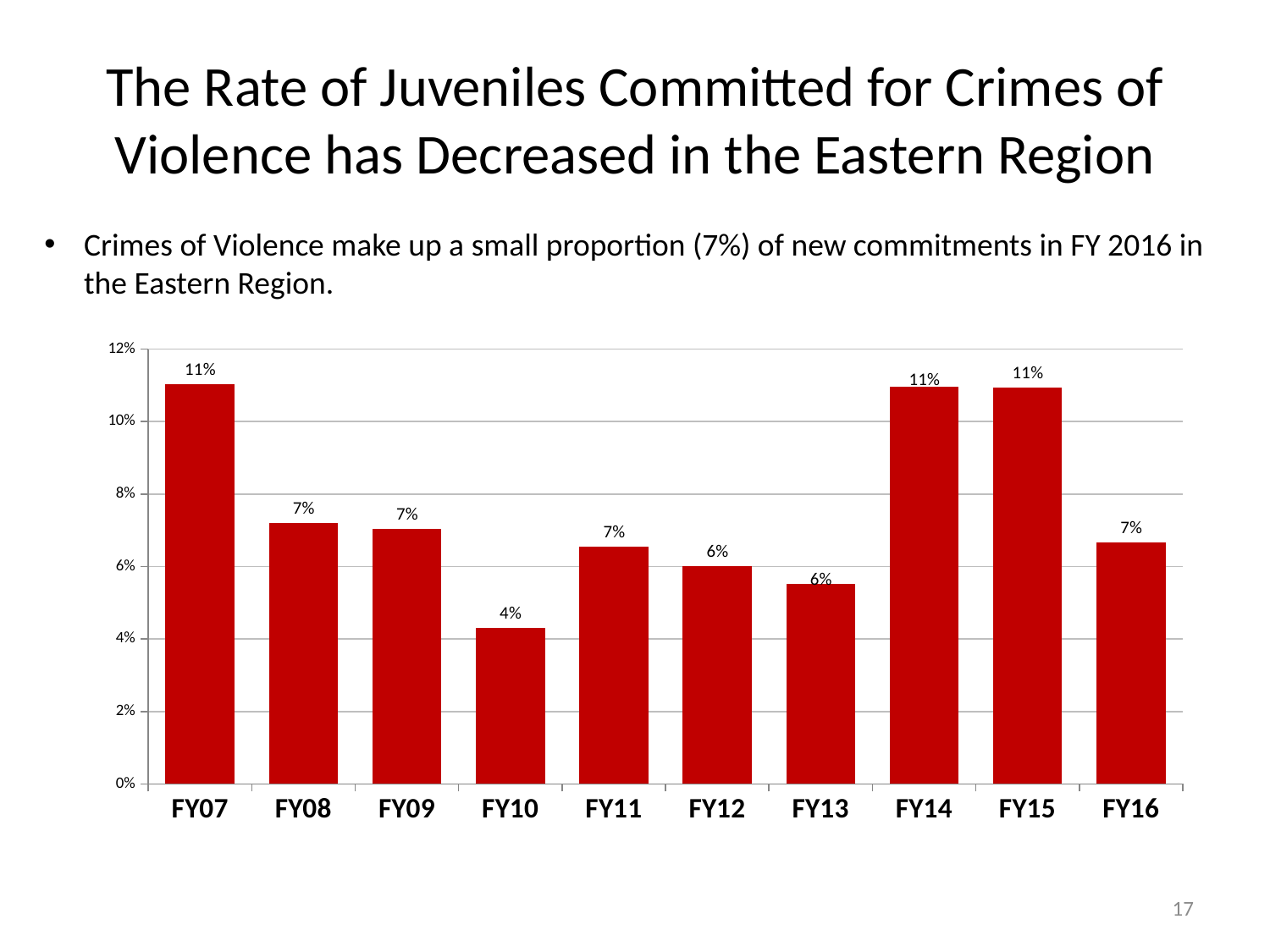
What kind of chart is shown on the slide? bar chart Is the value for FY14 greater or less than 10%? greater What is the value for FY12? 6% Is the value for FY13 greater or less than 8%? less How many fiscal years are shown on the x axis? 10 Do the values rise or fall from FY07 to FY10? fall Which fiscal year has the lowest value? FY10 What is the value for FY14? 11% Which is larger, the value for FY15 or the value for FY16? FY15 What is the difference between the values for FY07 and FY10? 7 percentage points What is the value for FY10? 4% What is the value for FY16? 7%